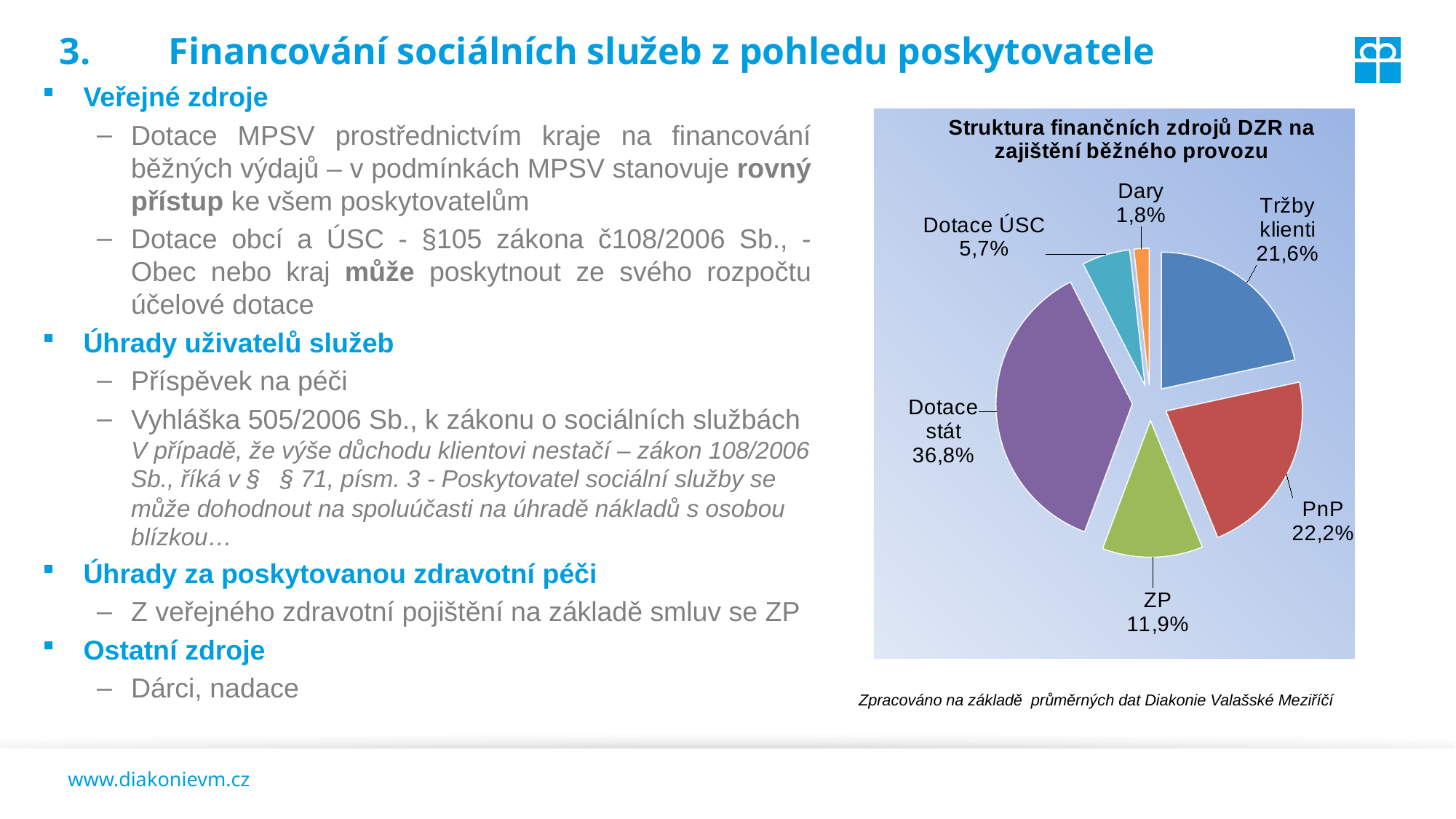
Which category has the smallest share of the pie? Dary What share of the pie does Dotace stát represent? 36,8% What is the value for Tržby klienti? 21,6% What is the title of the chart? Struktura finančních zdrojů DZR na zajištění běžného provozu What is the value for Dotace ÚSC? 5,7% How many slices does the pie chart have? 6 Which is larger, the share for Tržby klienti or the share for ZP? Tržby klienti What type of chart is shown on the slide? pie chart What is the difference in percentage points between Dotace ÚSC and Dary? 3,9 Which category has the largest share of the pie? Dotace stát What is the difference in percentage points between Dotace stát and PnP? 14,6 What is the value for ZP? 11,9%